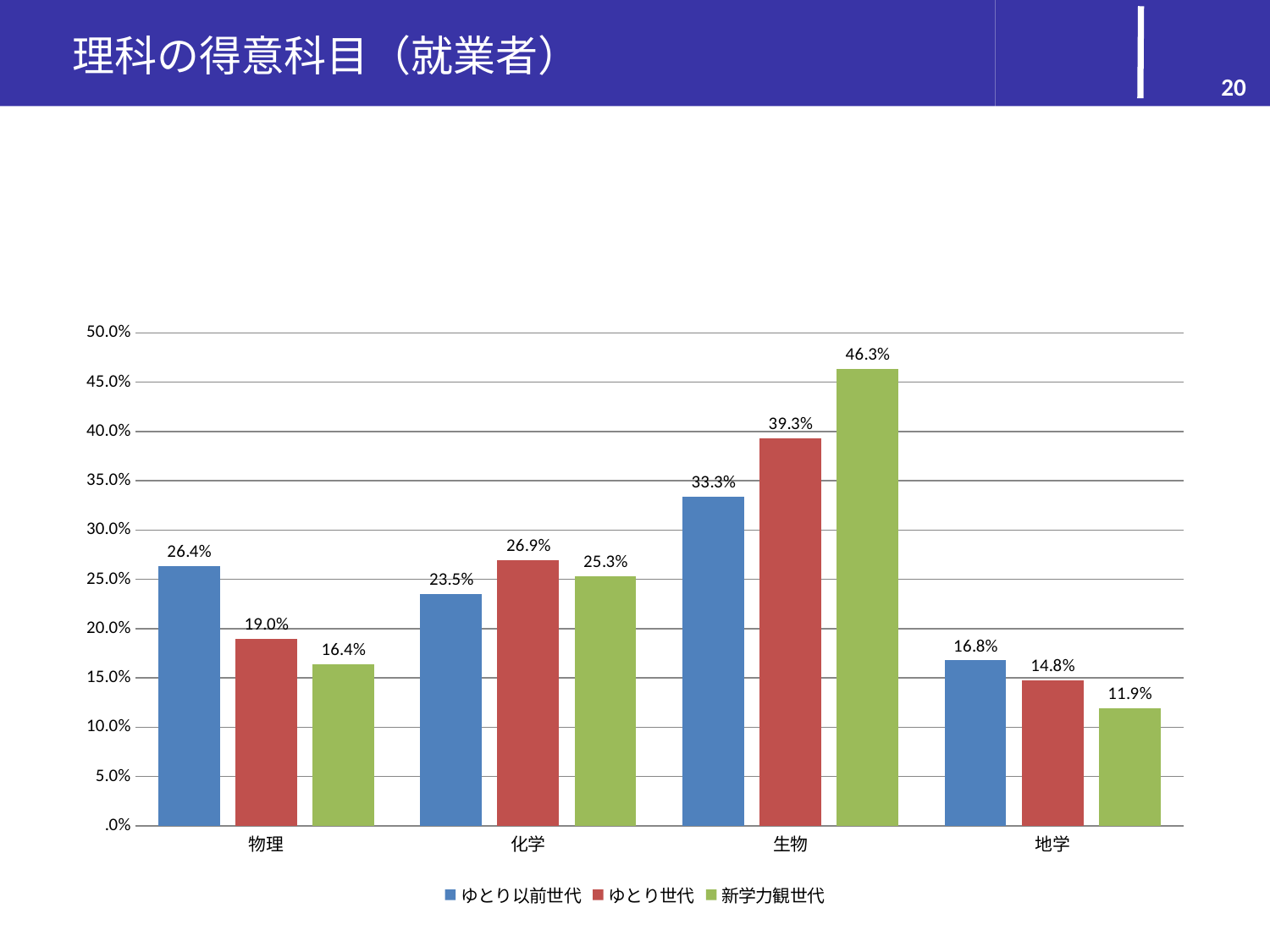
In the 物理 category, which series has the larger value, ゆとり以前世代 or 新学力観世代? ゆとり以前世代 How many categories are shown on the x axis? 4 What is the value for ゆとり世代 in the 化学 category? 26.9% Is the value for ゆとり世代 in the 生物 category greater or less than 35.0%? greater Which category has the highest value for 新学力観世代? 生物 How many series does the legend list? 3 What is the value for ゆとり以前世代 in the 生物 category? 33.3% What is the difference between 新学力観世代 and ゆとり以前世代 in the 生物 category? 13.0% Which category has the lowest value for ゆとり世代? 地学 What kind of chart is shown on the slide? bar chart What is the title of the slide? 理科の得意科目（就業者） What is the value for 新学力観世代 in the 地学 category? 11.9%